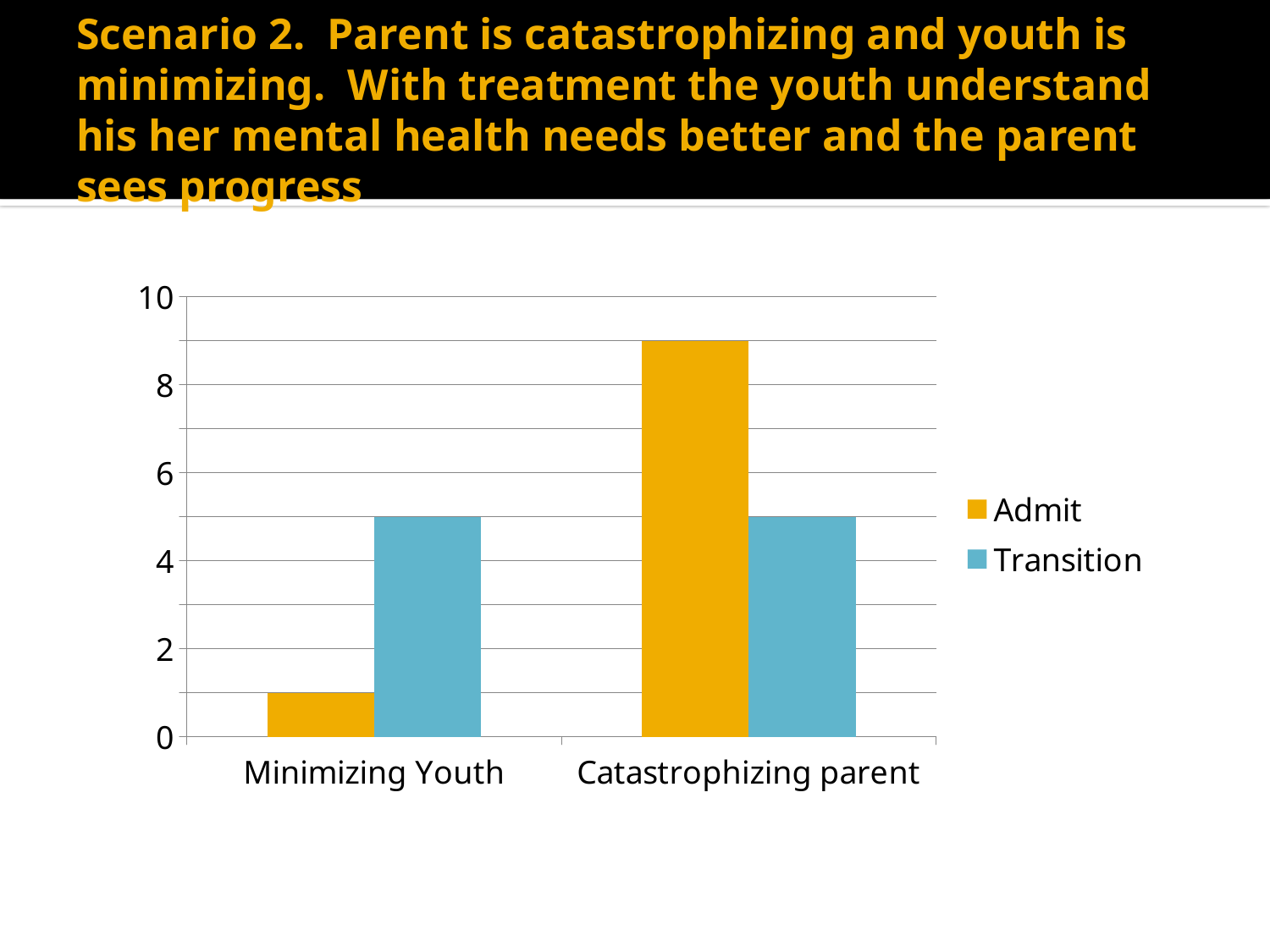
Which colour represents the Admit series in the chart? yellow/orange Is the Transition value for Catastrophizing parent greater or less than 6? less Is the Admit value for Catastrophizing parent greater or less than 8? greater Is the Admit value for Minimizing Youth greater or less than 2? less For Minimizing Youth, which is larger: the Admit value or the Transition value? Transition What are the two series named in the chart's legend? Admit and Transition How many categories are shown on the x axis of the chart? 2 What kind of chart is shown on the slide? bar chart How many series does the chart's legend list? 2 Which category has the higher Admit value? Catastrophizing parent For Catastrophizing parent, which is larger: the Admit value or the Transition value? Admit